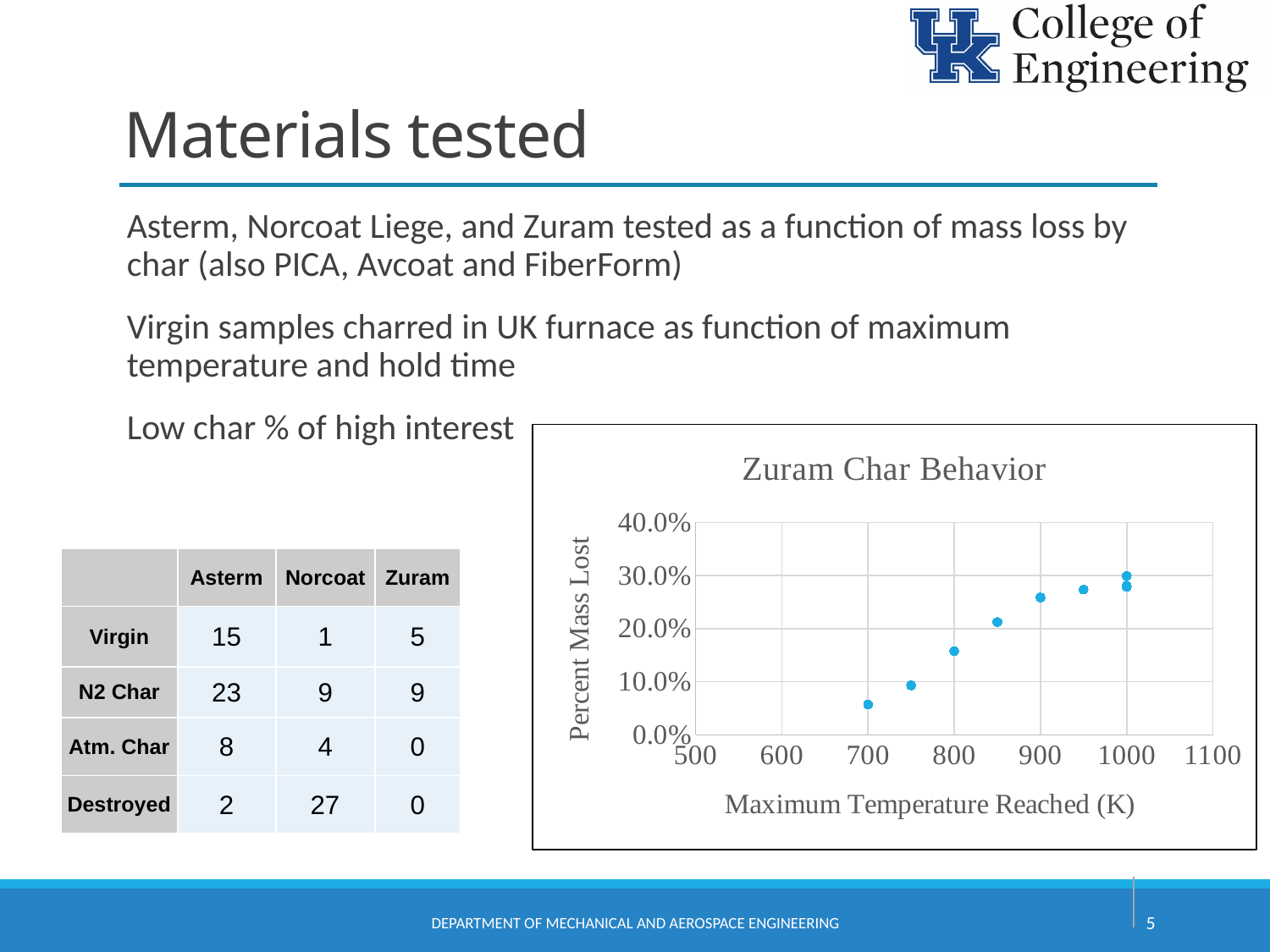
Is the percent mass lost at 800 K greater or less than 10.0%? greater What kind of chart is shown on the slide? scatter chart Which has the larger percent mass lost, the point at 700 K or the point at 900 K? 900 K At which maximum temperature is the highest percent mass lost recorded? 1000 K What is the title of the chart? Zuram Char Behavior Does the percent mass lost rise or fall as the maximum temperature increases? rise Is the percent mass lost at 700 K greater or less than 10.0%? less At which maximum temperature is the lowest percent mass lost recorded? 700 K Is the percent mass lost at 850 K greater or less than 30.0%? less What is the label of the x axis of the chart? Maximum Temperature Reached (K)